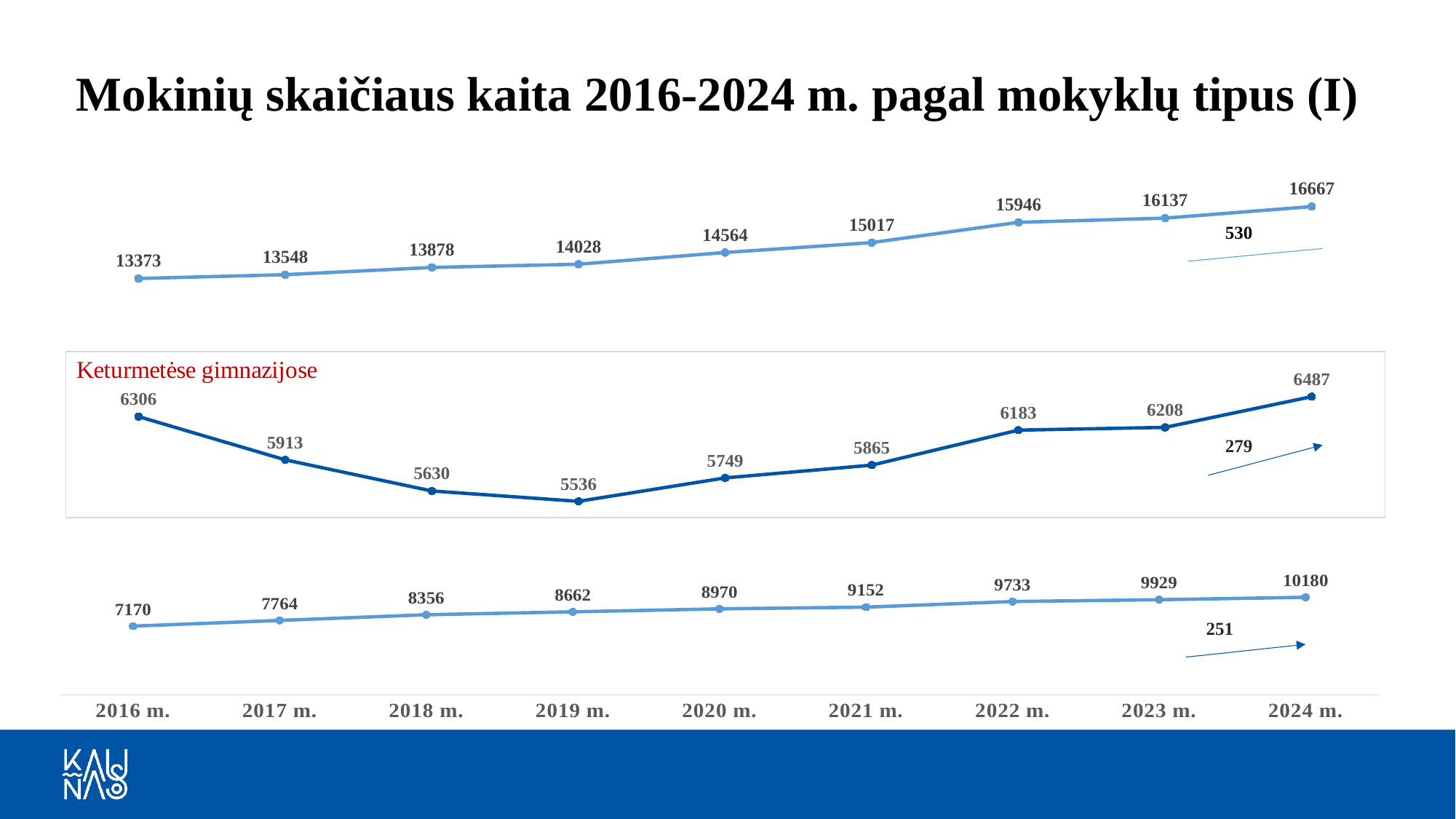
Which is larger: the 'Keturmetėse gimnazijose' value for 2017 m. or for 2018 m.? 2017 m. What is the difference between the 2024 m. and 2023 m. values of the top line? 530 In which year is the 'Keturmetėse gimnazijose' series at its highest? 2024 m. What is the value of the top line for 2020 m.? 14564 In which year is the 'Keturmetėse gimnazijose' series at its lowest? 2019 m. How many years are shown on the x axis? 9 What is the value for 2016 m. in the 'Keturmetėse gimnazijose' series? 6306 What is the value for 2024 m. in the 'Keturmetėse gimnazijose' series? 6487 What type of chart is shown on the slide? line chart What is the difference between the 2024 m. and 2023 m. values of the bottom line? 251 What is the value of the bottom line for 2016 m.? 7170 Does the bottom line rise or fall from 2016 m. to 2024 m.? rise